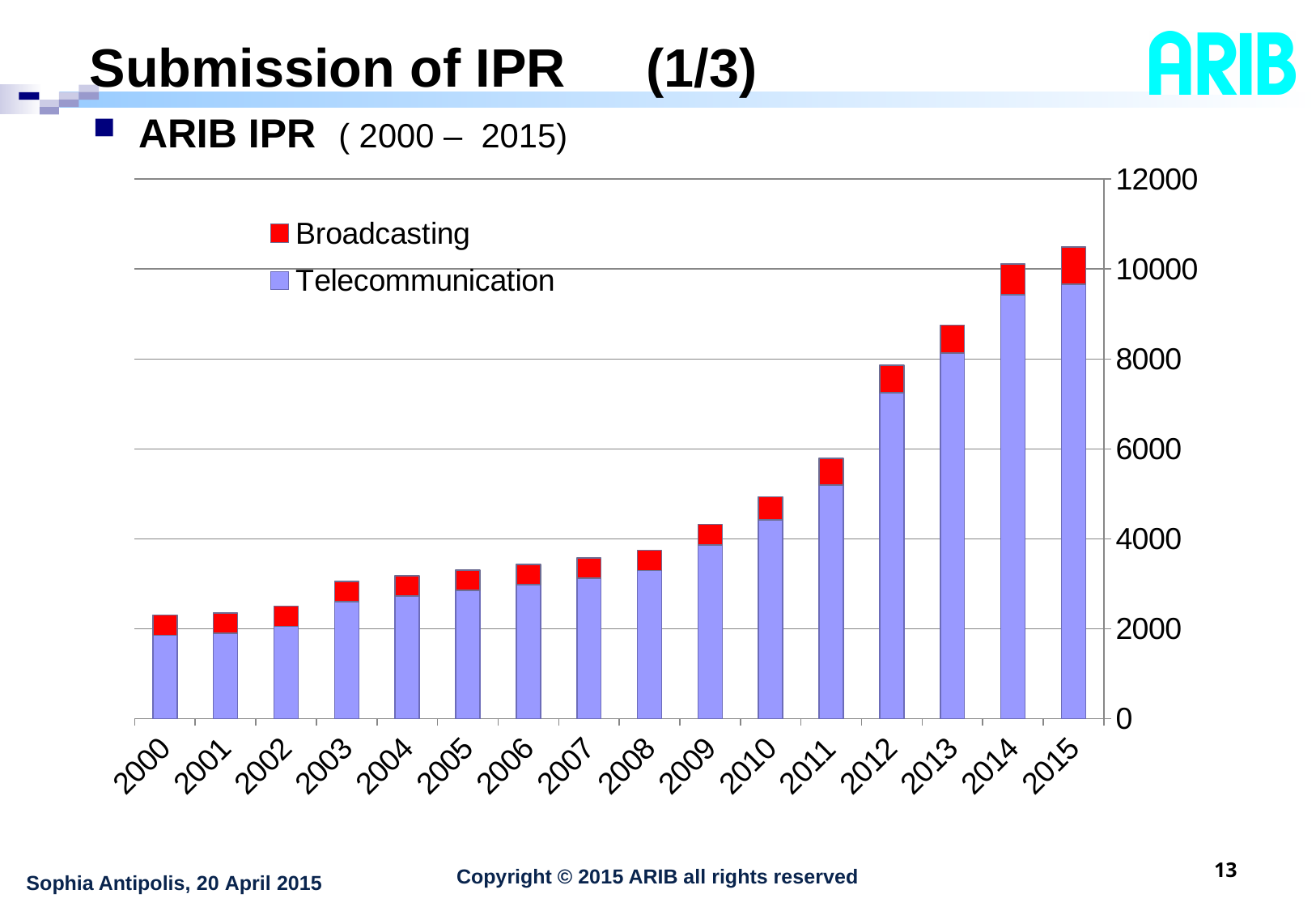
How many series does the chart's legend list? 2 Which year has the highest total bar in the chart? 2015 Do the total bar heights generally rise or fall from 2000 to 2015? Rise Is the total bar for 2000 greater or less than 2000? greater Is the total bar for 2010 greater or less than 6000? less Which colour represents the Broadcasting series in the chart? Red Which year has the larger total bar, 2003 or 2002? 2003 What kind of chart is shown on the slide? Stacked bar chart Which year has the lowest total bar in the chart? 2000 Is the total bar for 2015 greater or less than 10000? greater How many years are shown along the x axis of the chart? 16